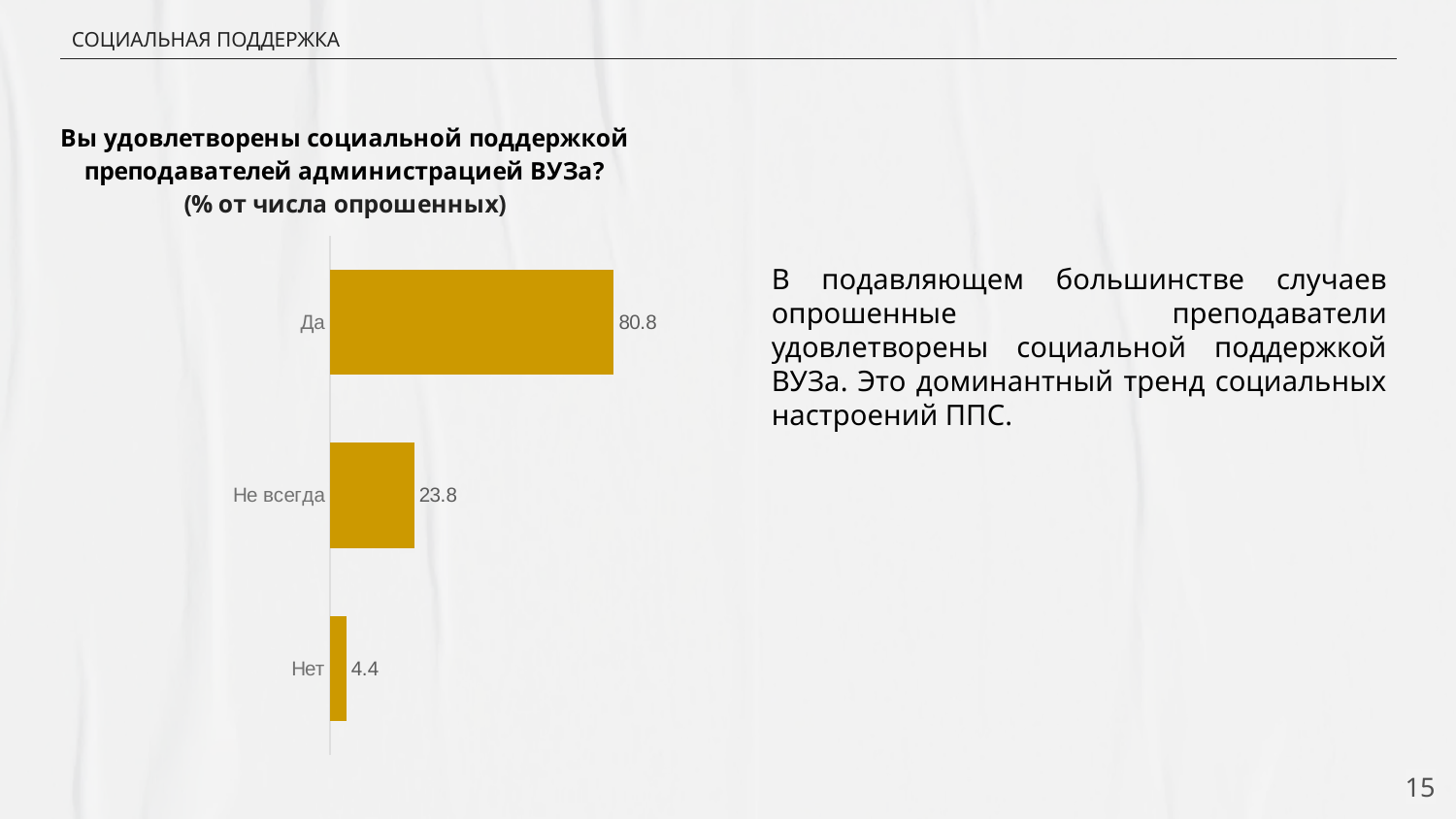
What is the difference between the values for "Не всегда" and "Нет"? 19.4 What is the value for "Нет"? 4.4 Which category has the highest value? Да What is the value for "Не всегда"? 23.8 What is the difference between the values for "Да" and "Не всегда"? 57.0 Which category has the lowest value? Нет How many categories are shown in the chart? 3 What is the title of the chart? Вы удовлетворены социальной поддержкой преподавателей администрацией ВУЗа? (% от числа опрошенных) What is the value for "Да"? 80.8 Which is larger, the value for "Не всегда" or the value for "Нет"? Не всегда What colour are the bars in the chart? gold What kind of chart is shown on the slide? bar chart